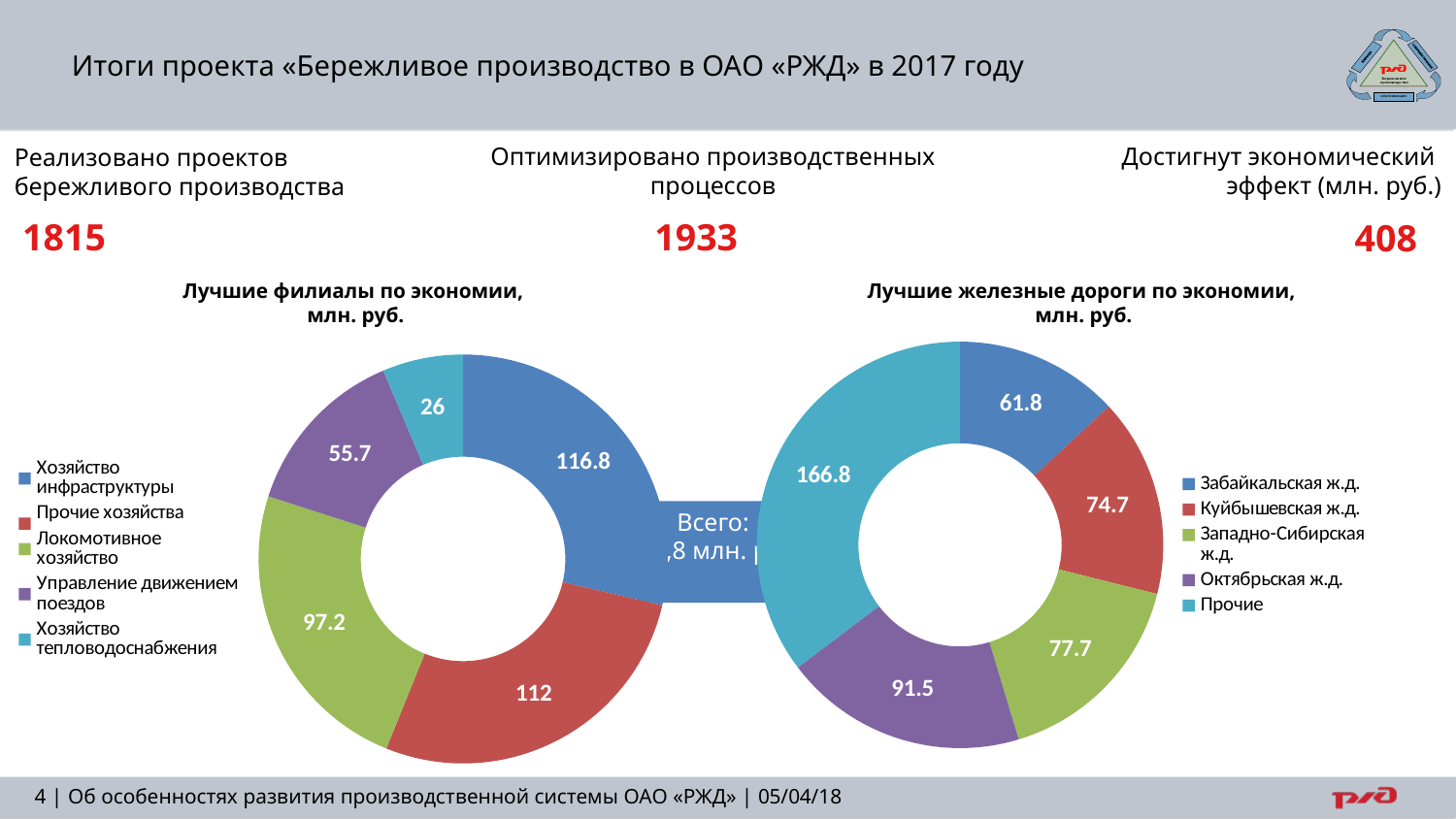
In the chart «Лучшие железные дороги по экономии, млн. руб.», which category has the largest value? Прочие In the chart «Лучшие филиалы по экономии, млн. руб.», what colour is the segment for Локомотивное хозяйство? Green In the chart «Лучшие железные дороги по экономии, млн. руб.», what is the value for Октябрьская ж.д.? 91.5 In the chart «Лучшие филиалы по экономии, млн. руб.», what is the value for Локомотивное хозяйство? 97.2 In the chart «Лучшие филиалы по экономии, млн. руб.», what is the difference between Прочие хозяйства and Управление движением поездов? 56.3 What type of chart is «Лучшие железные дороги по экономии, млн. руб.»? Doughnut chart In the chart «Лучшие филиалы по экономии, млн. руб.», which category has the smallest value? Хозяйство тепловодоснабжения In the chart «Лучшие железные дороги по экономии, млн. руб.», which is larger: Забайкальская ж.д. or Октябрьская ж.д.? Октябрьская ж.д. In the chart «Лучшие железные дороги по экономии, млн. руб.», what is the value for Куйбышевская ж.д.? 74.7 In the chart «Лучшие филиалы по экономии, млн. руб.», what is the value for Хозяйство инфраструктуры? 116.8 In the chart «Лучшие филиалы по экономии, млн. руб.», how many categories are shown? 5 In the chart «Лучшие железные дороги по экономии, млн. руб.», what is the difference between Прочие and Забайкальская ж.д.? 105